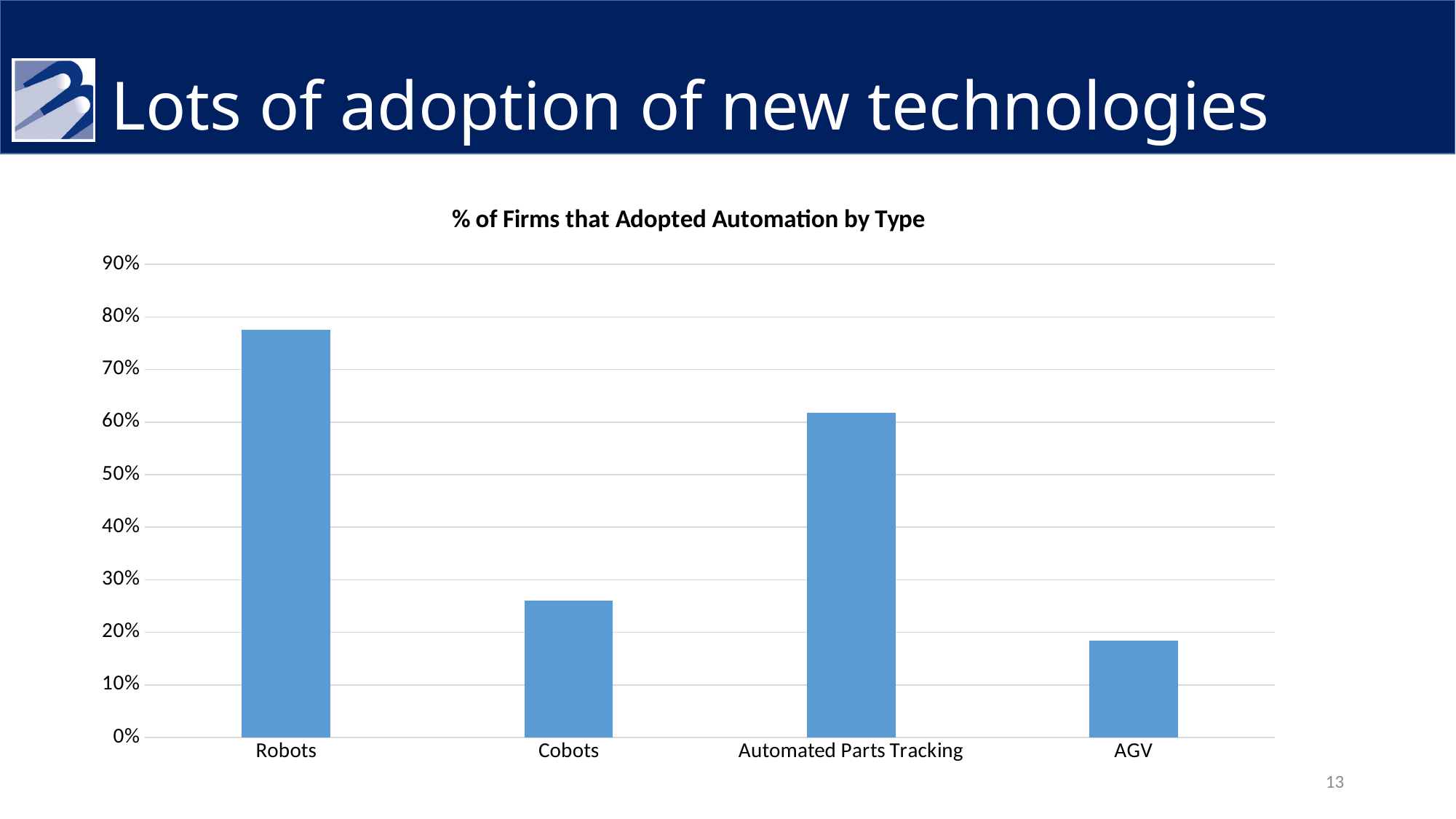
What kind of chart is shown on the slide? bar chart Is the value for AGV greater or less than 20%? less Is the value for Robots greater or less than 70%? greater Which category has the highest value? Robots What is the highest value labelled on the y axis of the chart? 90% Is the value for Cobots greater or less than 30%? less How many categories are shown on the x axis of the chart? 4 Which category has the lowest value? AGV What is the title of the chart? % of Firms that Adopted Automation by Type Which is larger, the value for Cobots or the value for Automated Parts Tracking? Automated Parts Tracking Which is larger, the value for Cobots or the value for AGV? Cobots